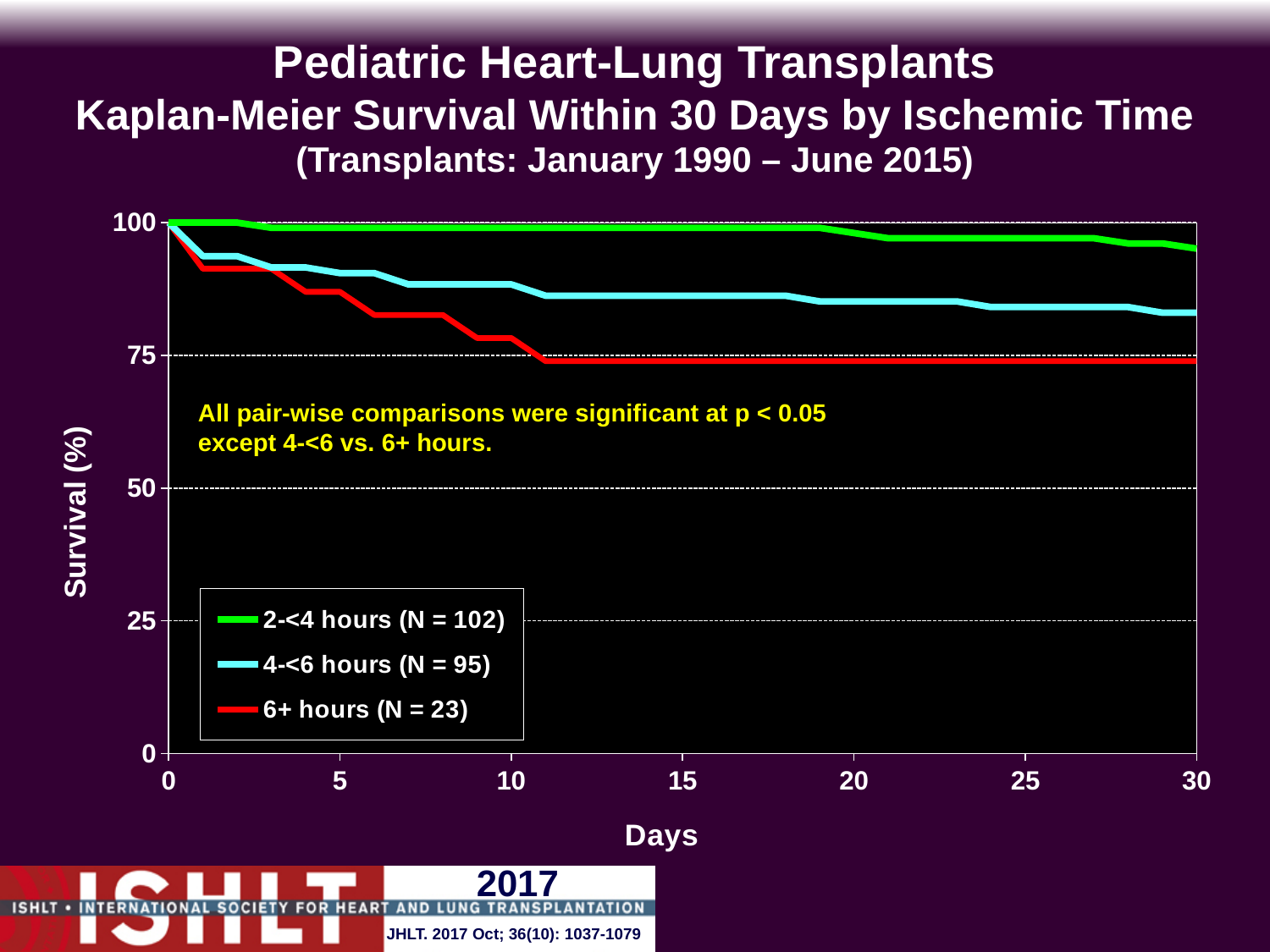
How many series does the legend list? 3 Is the survival for the 6+ hours group at day 30 greater or less than 75? less According to the legend, how many patients (N) are in the 6+ hours group? 23 According to the legend, how many patients (N) are in the 2-<4 hours group? 102 Do the survival curves rise or fall as days increase? Fall According to the legend, how many patients (N) are in the 4-<6 hours group? 95 Which ischemic time group has the lowest survival at day 30? 6+ hours Which ischemic time group has the highest survival at day 30? 2-<4 hours What kind of chart is shown on the slide? Line chart At day 30, which group has higher survival: 4-<6 hours or 6+ hours? 4-<6 hours Which pair-wise comparison was not significant at p < 0.05 according to the annotation on the chart? 4-<6 vs. 6+ hours Is the survival for the 4-<6 hours group at day 30 greater or less than 75? greater